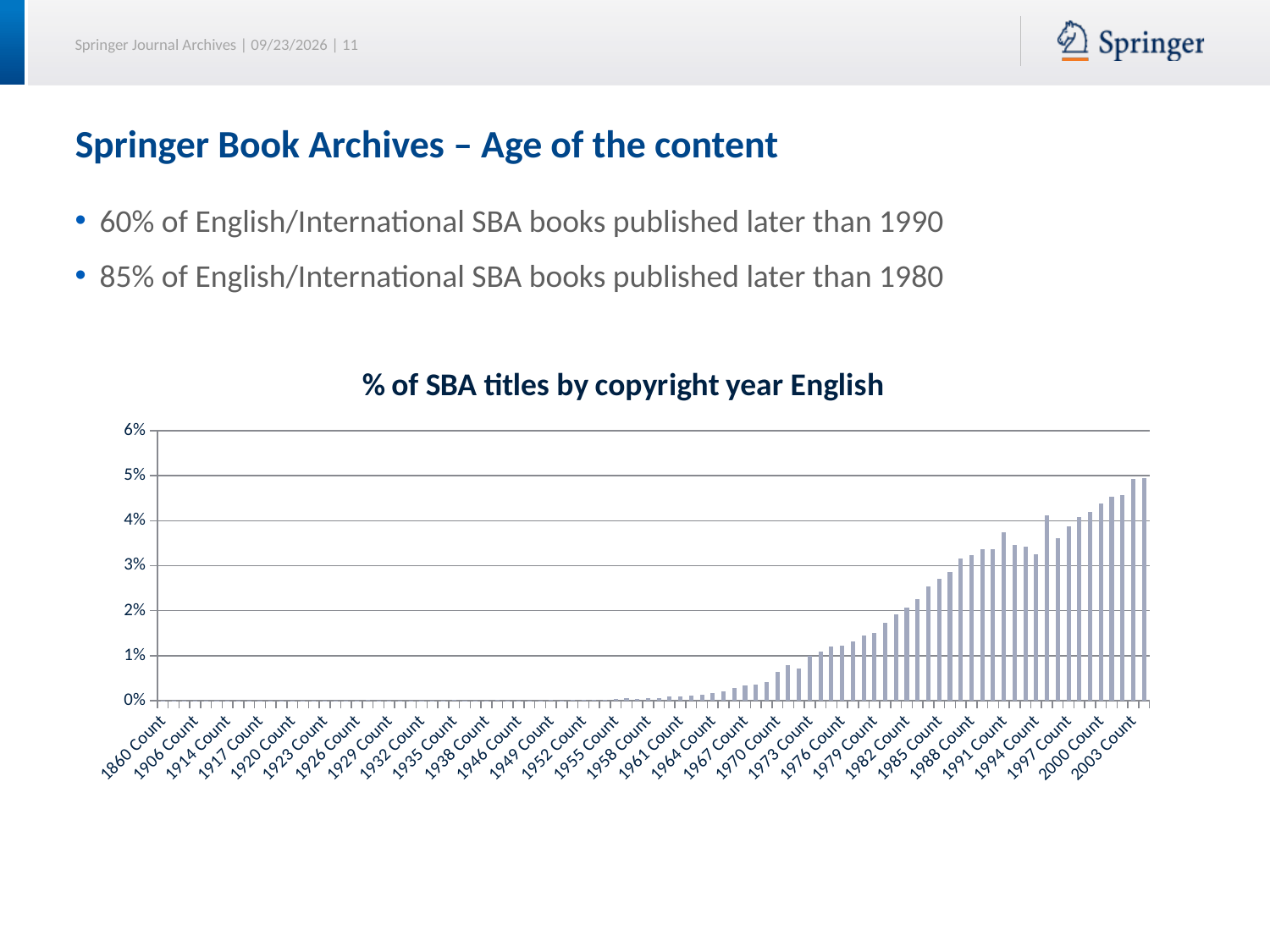
Is the value for 2003 Count greater or less than 3%? greater Which is larger, the value for 2003 Count or the value for 1920 Count? 2003 Count What is the highest value shown on the y axis? 6% Is the value for 1970 Count greater or less than 2%? less Is the value for 1991 Count greater or less than 1%? greater What is the title of the chart? % of SBA titles by copyright year English Do the values generally rise or fall moving from left to right along the x axis? rise What kind of chart is shown on the slide? bar chart